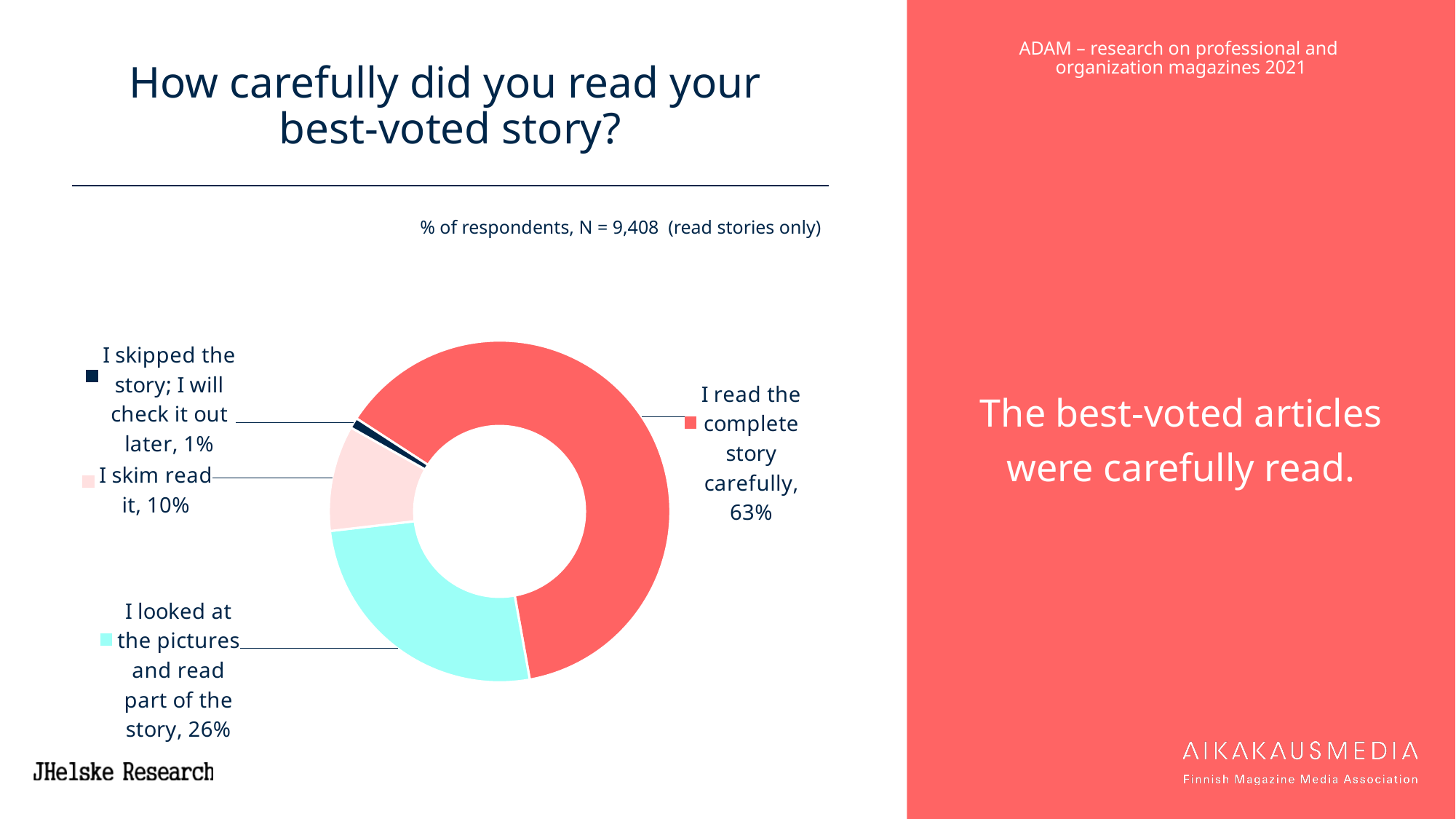
What is the number of respondents (N) stated for the chart? 9,408 What kind of chart is shown on the slide? Pie chart (doughnut) Which is larger: the share who skim read the story or the share who looked at the pictures and read part of the story? I looked at the pictures and read part of the story Which response has the largest share of respondents? I read the complete story carefully What is the title of the chart on the slide? How carefully did you read your best-voted story? What percentage of respondents skim read the story? 10% What percentage of respondents looked at the pictures and read part of the story? 26% What percentage of respondents said they read the complete story carefully? 63% What percentage of respondents skipped the story and will check it out later? 1% What is the difference in percentage points between those who read the complete story carefully and those who looked at the pictures and read part of the story? 37 Which response has the smallest share of respondents? I skipped the story; I will check it out later How many response categories are shown in the chart? 4